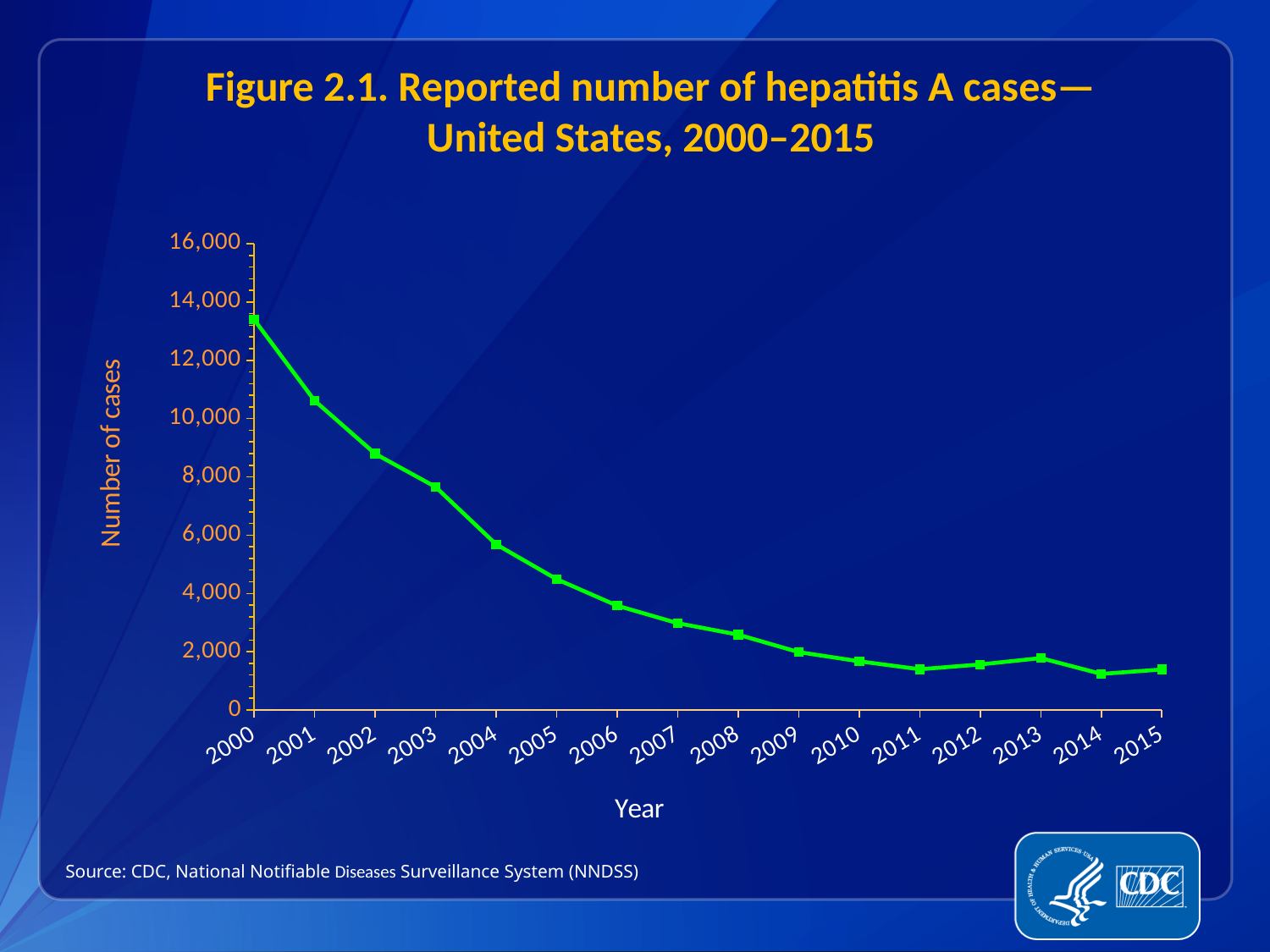
Which year has more reported cases, 2003 or 2008? 2003 Is the number of cases in 2003 greater or less than 8,000? less Which year has the highest reported number of hepatitis A cases? 2000 Is the number of cases in 2000 greater or less than 12,000? greater How many years are plotted on the x axis? 16 Is the number of cases in 2001 greater or less than 10,000? greater What is the label on the y axis of the chart? Number of cases Do the reported hepatitis A cases generally rise or fall from 2000 to 2015? fall What kind of chart is shown on the slide? line chart